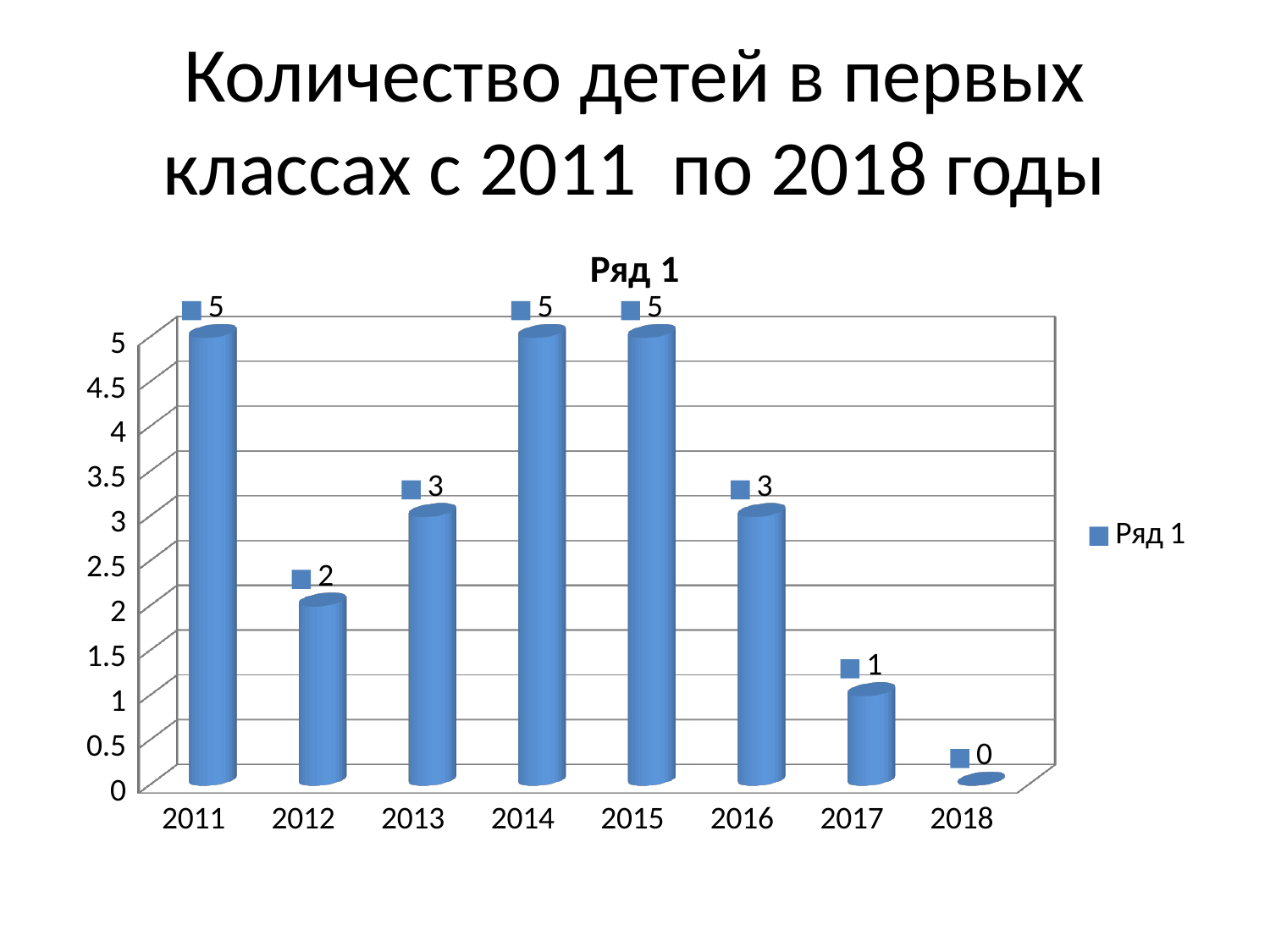
What kind of chart is shown on the slide? bar chart Do the values rise or fall from 2015 to 2018? fall What is the name of the series shown in the legend? Ряд 1 How many years are shown on the x axis? 8 What is the difference between the values for 2011 and 2012? 3 Which year has the lowest value? 2018 How many series does the legend list? 1 What is the difference between the values for 2014 and 2016? 2 What is the value for 2017? 1 What is the value for 2012? 2 Which is larger, the value for 2016 or the value for 2017? 2016 What is the value for 2013? 3